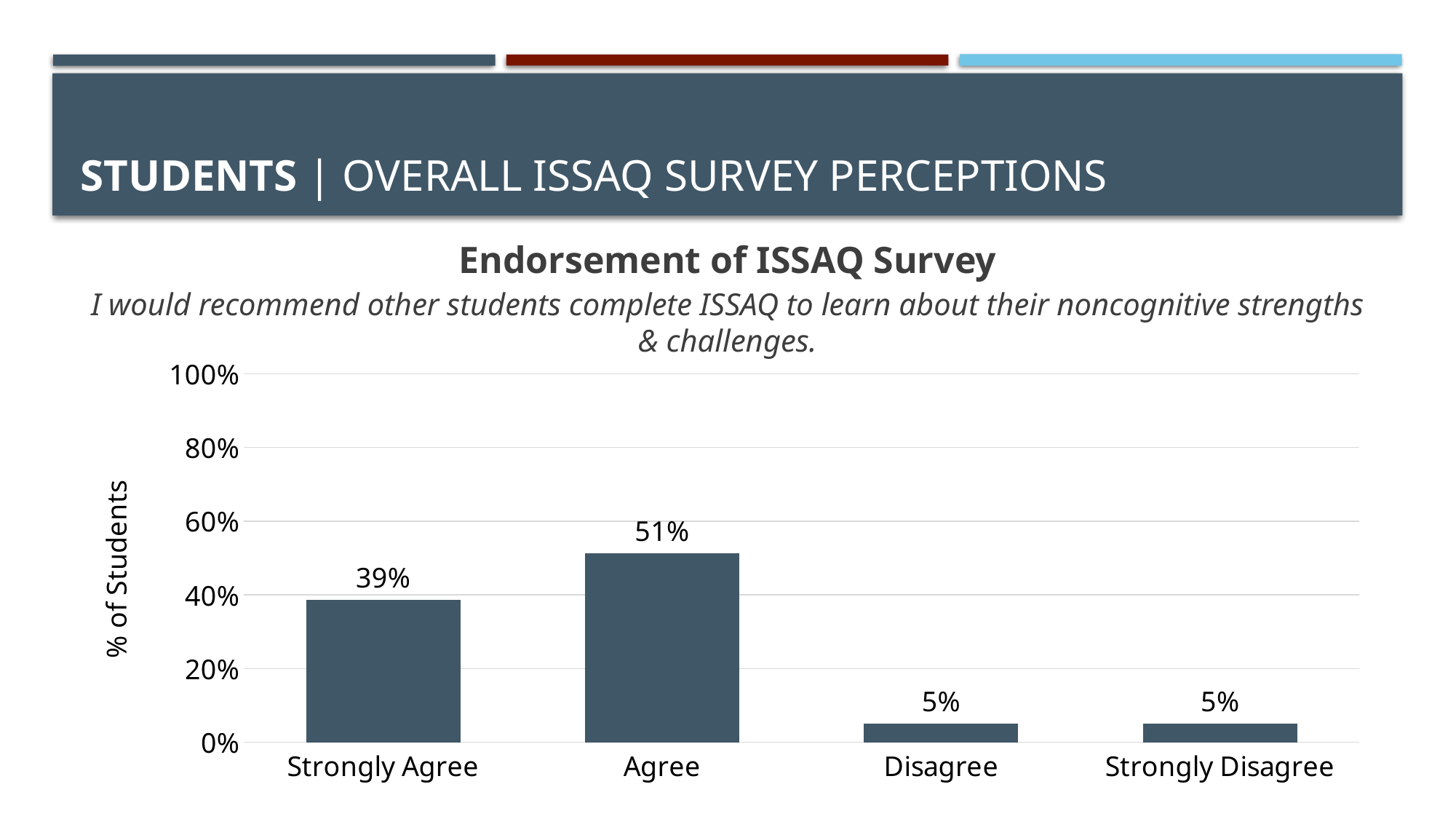
Which is larger, the value for Strongly Agree or the value for Disagree? Strongly Agree What is the title of the chart? Endorsement of ISSAQ Survey What percentage of students selected Disagree? 5% Which response category has the highest percentage of students? Agree What kind of chart is shown on the slide? Bar chart What is the combined percentage of students who selected Strongly Agree or Agree? 90% What percentage of students selected Agree? 51% How many response categories are shown on the x axis? 4 What is the difference in percentage points between Agree and Strongly Agree? 12% Is the value for Agree greater or less than 40%? greater What percentage of students selected Strongly Agree? 39% Is the value for Strongly Agree greater or less than 40%? less